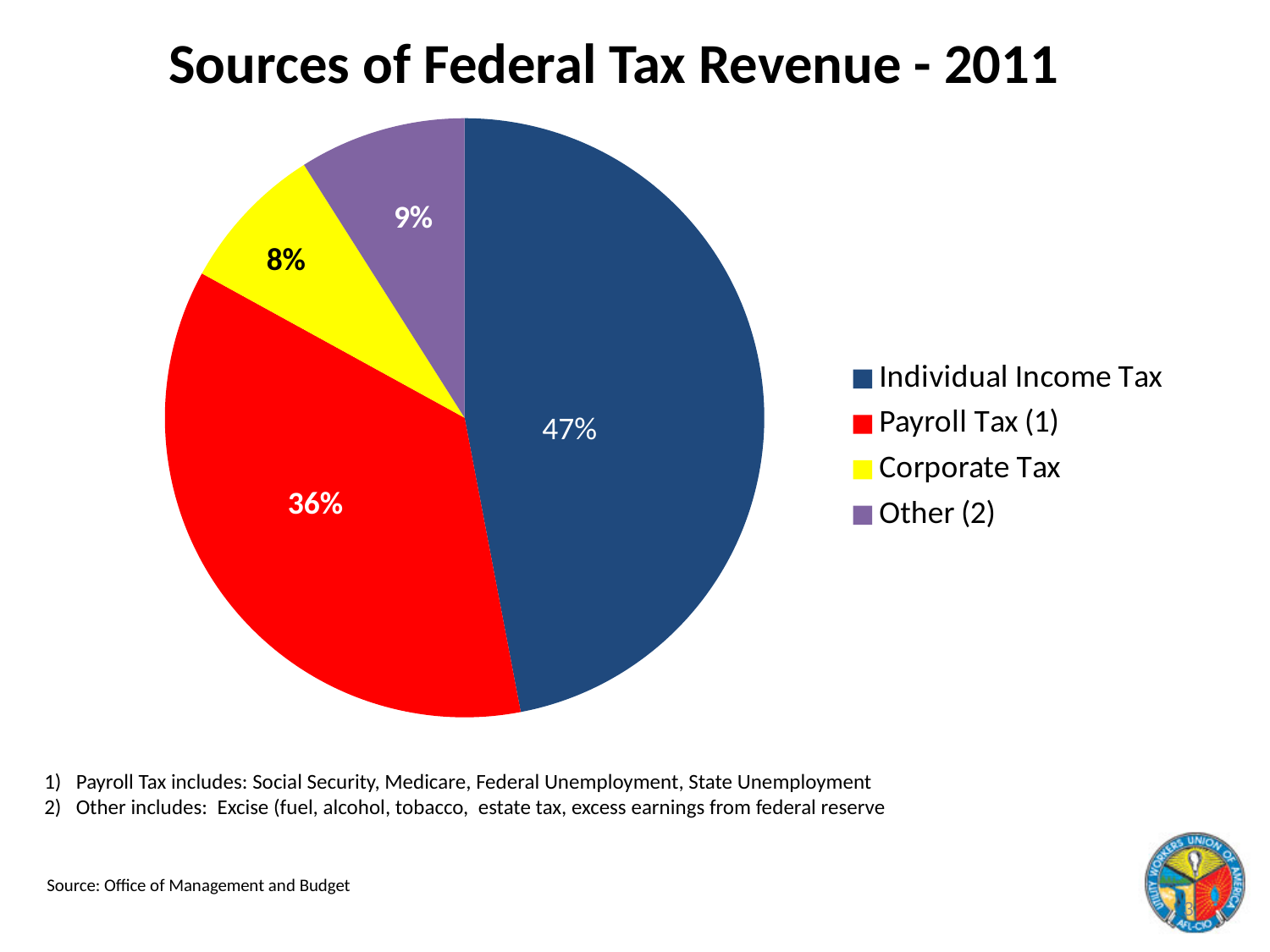
What share of federal tax revenue comes from Other (2)? 9% What share of federal tax revenue comes from Payroll Tax (1)? 36% What kind of chart is shown on the slide? Pie chart Which source accounts for the smallest share of federal tax revenue? Corporate Tax Which colour represents Payroll Tax (1) in the pie chart? Red What share of federal tax revenue comes from Individual Income Tax? 47% Which is larger, the share for Other (2) or the share for Corporate Tax? Other (2) What is the title of the chart? Sources of Federal Tax Revenue - 2011 What share of federal tax revenue comes from Corporate Tax? 8% How many slices does the pie chart have? 4 Which source accounts for the largest share of federal tax revenue? Individual Income Tax How many percentage points larger is the Individual Income Tax share than the Payroll Tax (1) share? 11